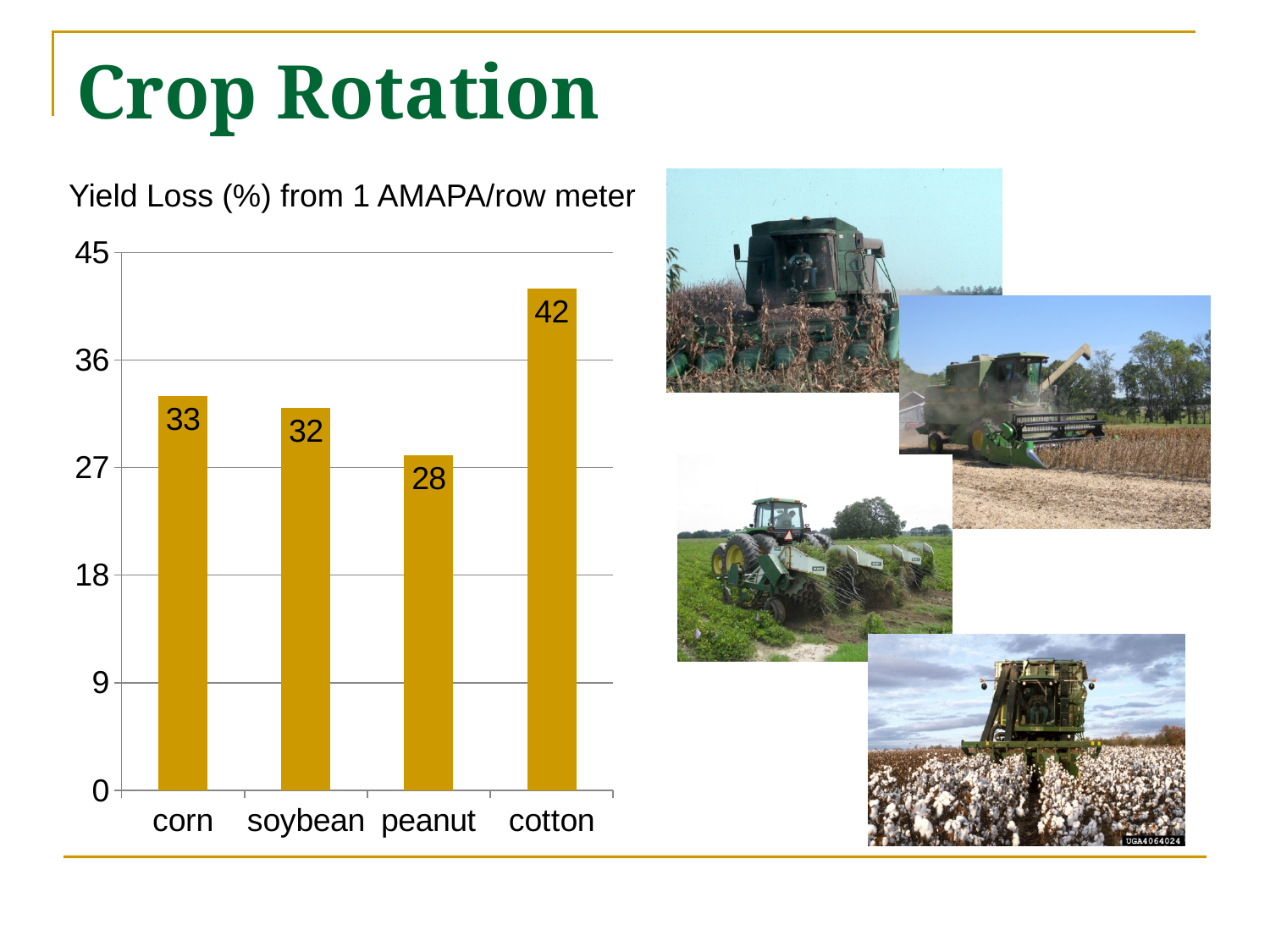
What is the difference in yield loss between cotton and peanut? 14 Is the value for cotton greater or less than 36? greater What is the yield loss value for peanut? 28 Which crop has the lowest yield loss? peanut What is the title of the chart? Yield Loss (%) from 1 AMAPA/row meter Which crop has the highest yield loss? cotton What kind of chart is shown on the slide? bar chart Which has a larger yield loss, cotton or corn? cotton What is the yield loss value for corn? 33 What is the difference in yield loss between corn and soybean? 1 What is the yield loss value for cotton? 42 How many crops are shown in the chart? 4